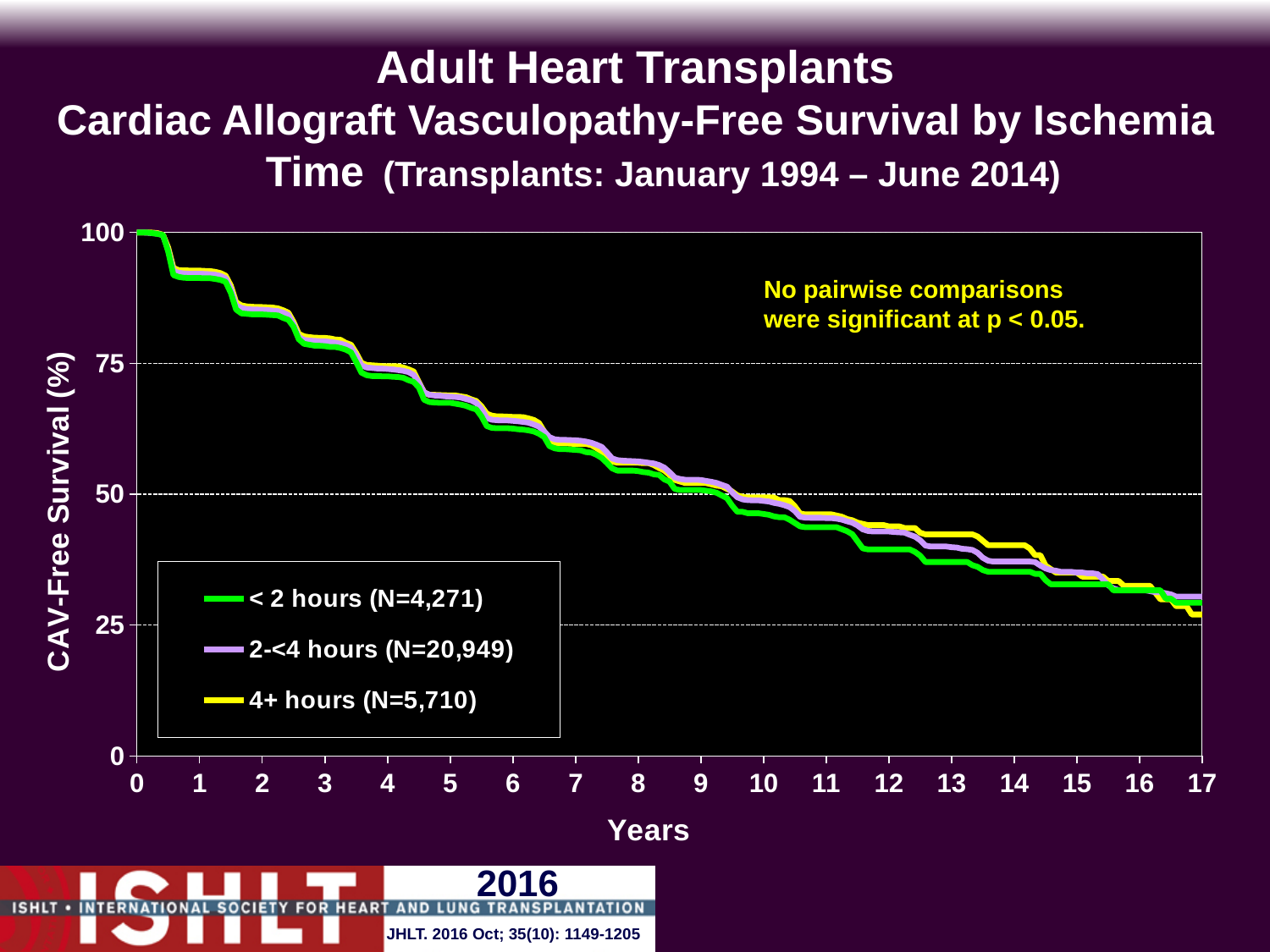
Is the CAV-free survival for the 4+ hours group at year 5 greater or less than 75? less What is the CAV-free survival (%) for all three ischemia time groups at year 0? 100 Is the CAV-free survival for the < 2 hours group at year 15 greater or less than 25? greater Is the CAV-free survival for the 4+ hours group at year 2 greater or less than 75? greater What is the N for the 2-<4 hours group shown in the legend? N=20,949 How many series does the legend list? 3 Do the CAV-free survival curves rise or fall as years since transplant increase? fall What is the label of the y axis? CAV-Free Survival (%) What kind of chart is shown on the slide? line chart